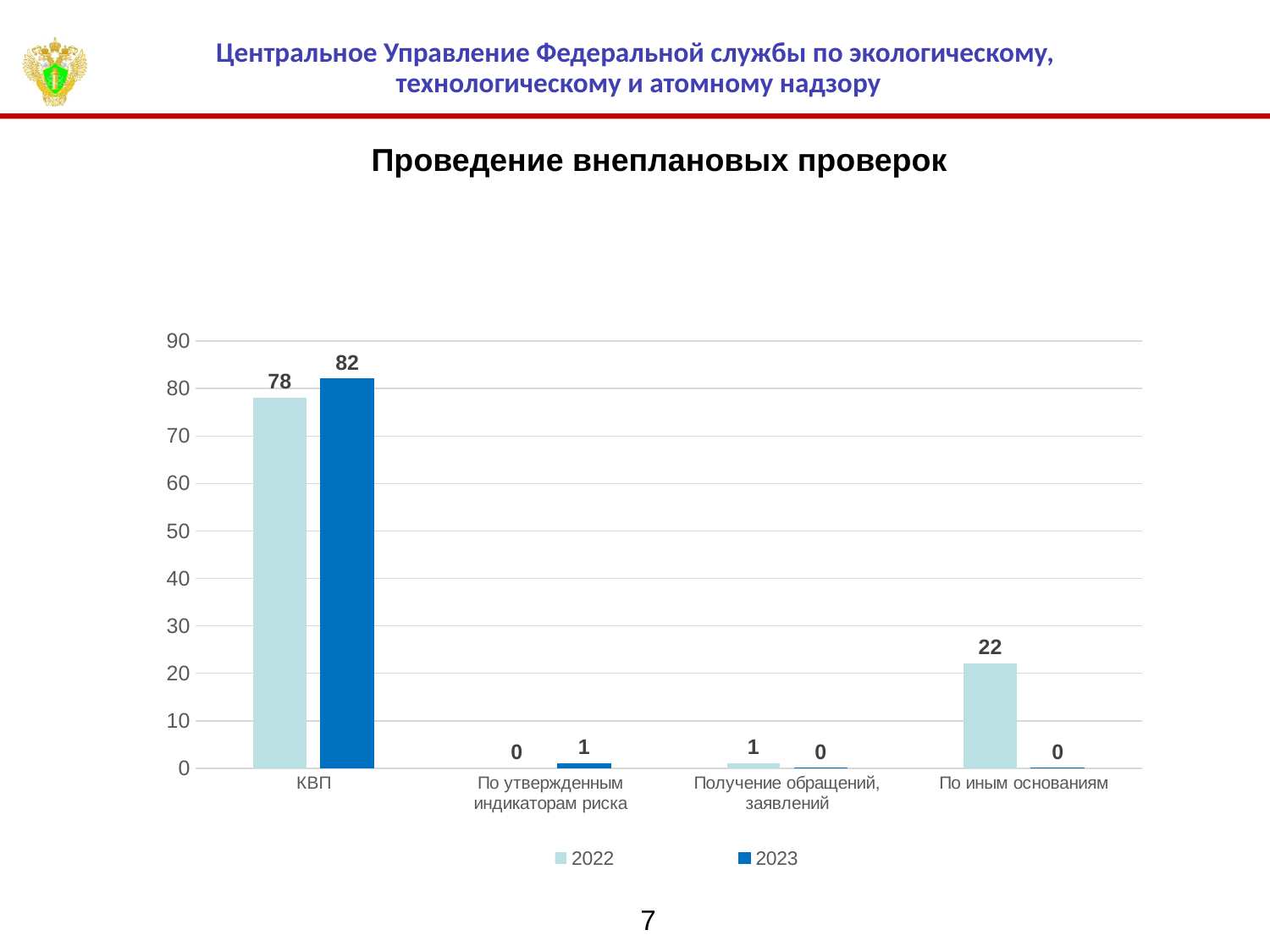
Which is larger for По иным основаниям, the 2022 value or the 2023 value? 2022 What kind of chart is shown on the slide? bar chart What is the value for КВП in 2023? 82 What is the value for По утвержденным индикаторам риска in 2023? 1 Which category has the highest value for 2022? КВП What is the value for КВП in 2022? 78 What is the value for По иным основаниям in 2022? 22 How many categories are shown on the x axis? 4 What is the title of the chart? Проведение внеплановых проверок How many series does the legend list? 2 What is the difference between the 2023 and 2022 values for КВП? 4 What is the difference between the 2022 values for КВП and По иным основаниям? 56